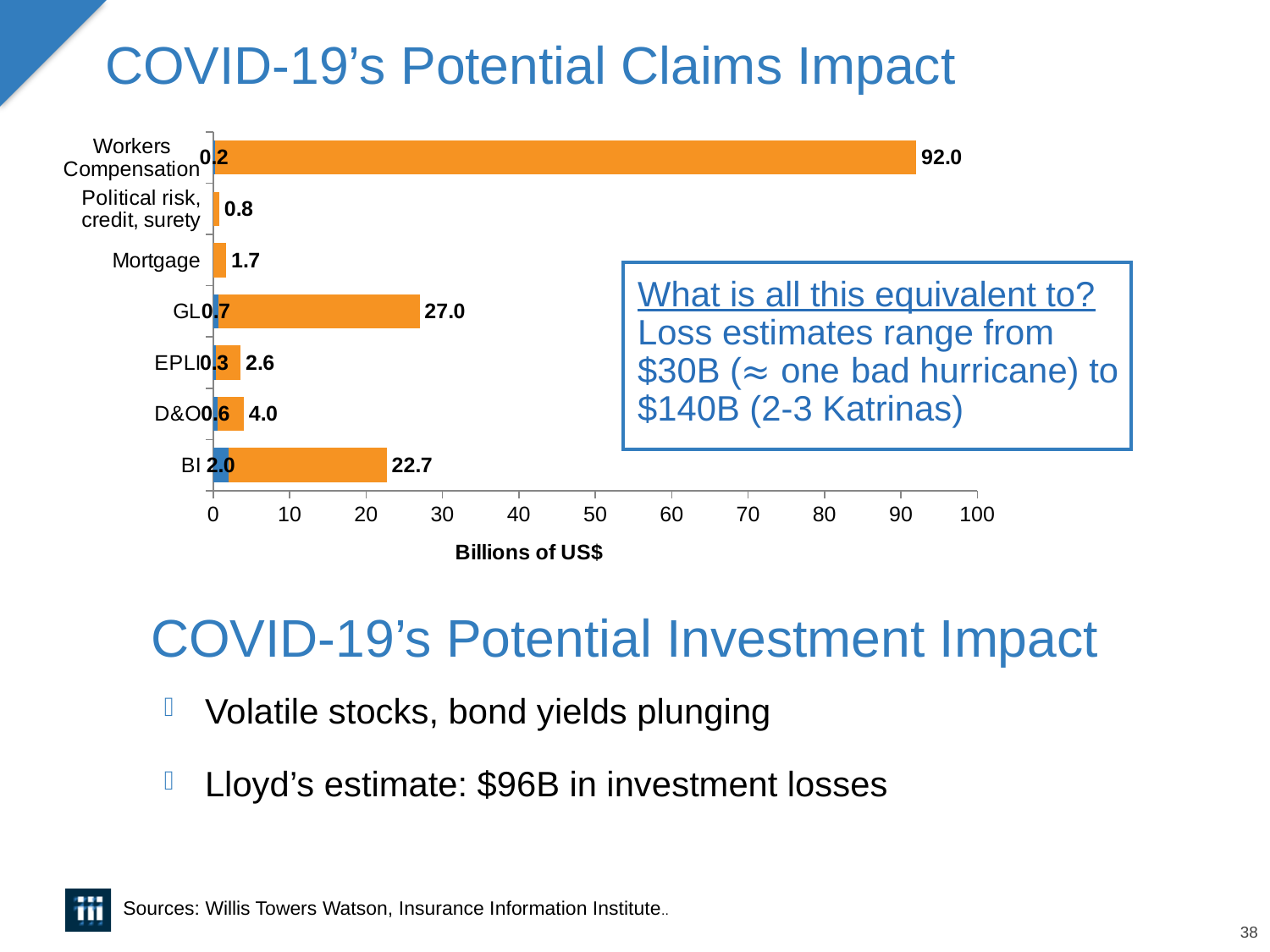
Is the orange bar value for Workers Compensation greater or less than 90? greater What is the value of the blue bar for BI? 2.0 What is the label of the horizontal axis? Billions of US$ What is the value shown for Mortgage? 1.7 How many categories are shown on the chart's vertical axis? 7 What is the difference between the orange bar values for GL and BI? 4.3 What type of chart is shown on the slide? bar chart What is the value of the orange bar for BI? 22.7 Which category has the highest orange bar value? Workers Compensation What is the value of the orange bar for GL? 27.0 What is the value of the orange bar for Workers Compensation? 92.0 Which has a larger orange bar value, D&O or EPLI? D&O